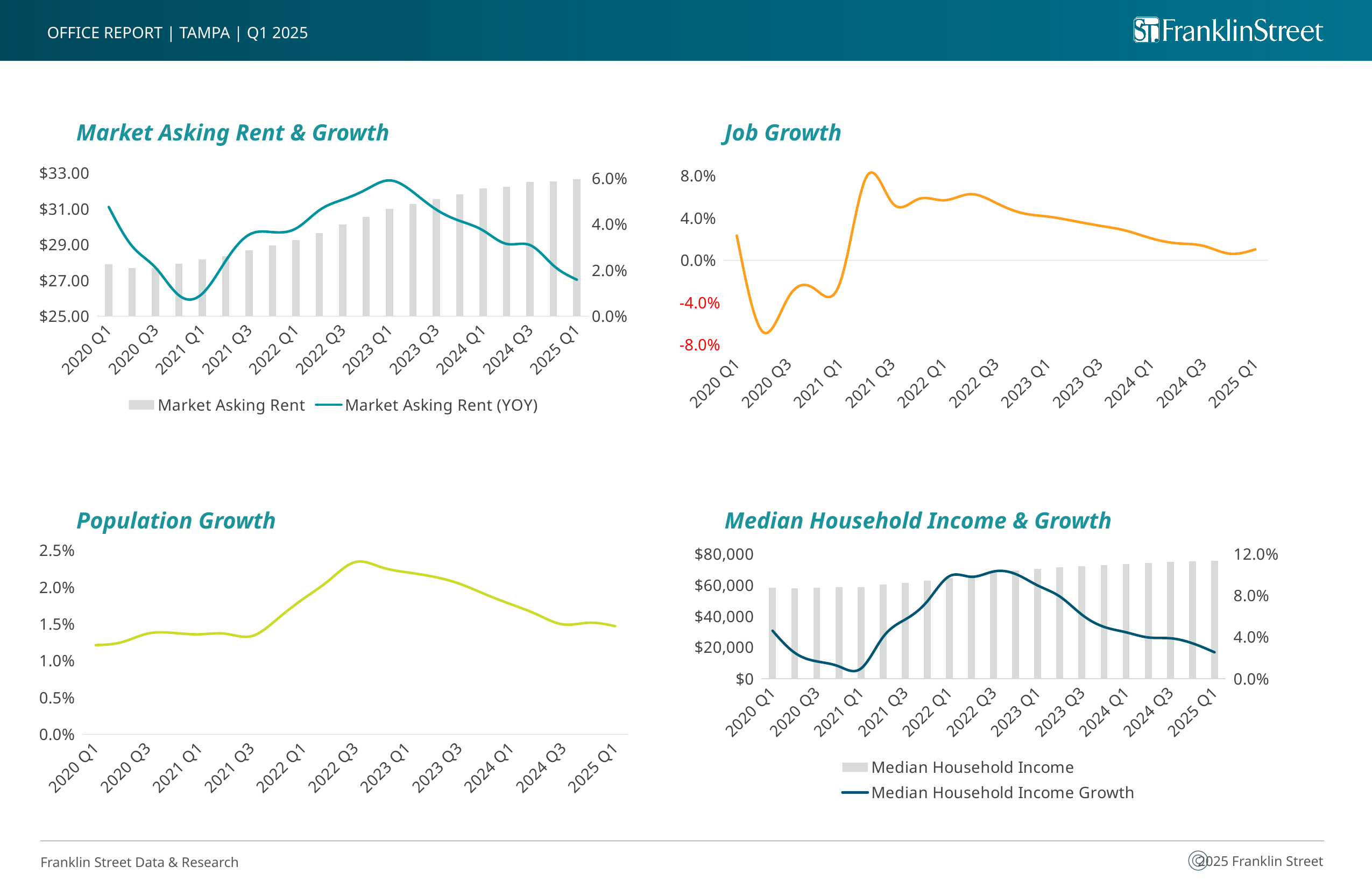
In the Population Growth chart, does the line rise or fall from 2022 Q3 to 2025 Q1? fall In the Median Household Income & Growth chart, is the Median Household Income Growth for 2021 Q1 greater or less than 4.0%? less In the Median Household Income & Growth chart, is the Median Household Income for 2025 Q1 greater or less than $60,000? greater What kind of chart is the Job Growth chart? line chart In the Market Asking Rent & Growth chart, what kind of chart is the Market Asking Rent series drawn as? bar chart In the Market Asking Rent & Growth chart, do the Market Asking Rent bars generally rise or fall from 2021 Q1 to 2025 Q1? rise In the Job Growth chart, is the value for 2021 Q3 greater or less than 4.0%? greater How many series does the legend of the Market Asking Rent & Growth chart list? 2